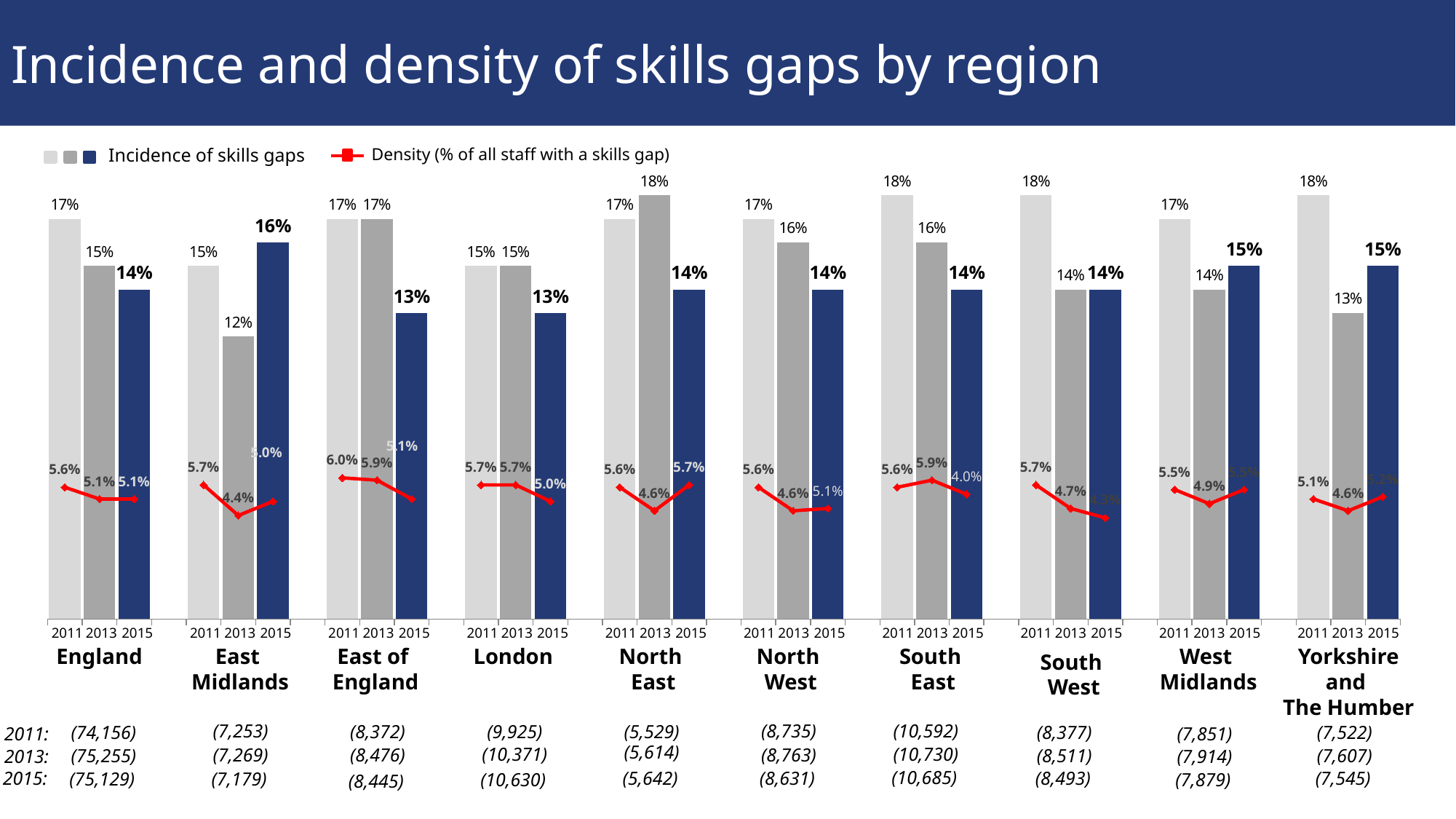
What is the incidence of skills gaps for East Midlands in 2015? 16% By how many percentage points did the incidence of skills gaps in England fall between 2011 and 2015? 3 percentage points What is the density of skills gaps for East of England in 2011? 6.0% Which region has the highest incidence of skills gaps in 2015? East Midlands Which had a higher incidence of skills gaps in 2013: North East or London? North East What is the incidence of skills gaps for London in 2013? 15% What does the red line on the chart represent? Density (% of all staff with a skills gap) What is the density of skills gaps for East Midlands in 2013? 4.4% Which region has the lowest incidence of skills gaps in 2013? East Midlands Did the incidence of skills gaps in East of England rise or fall from 2011 to 2015? Fall What kind of chart is used to show the incidence of skills gaps? Bar chart How many regions are shown on the chart? 10